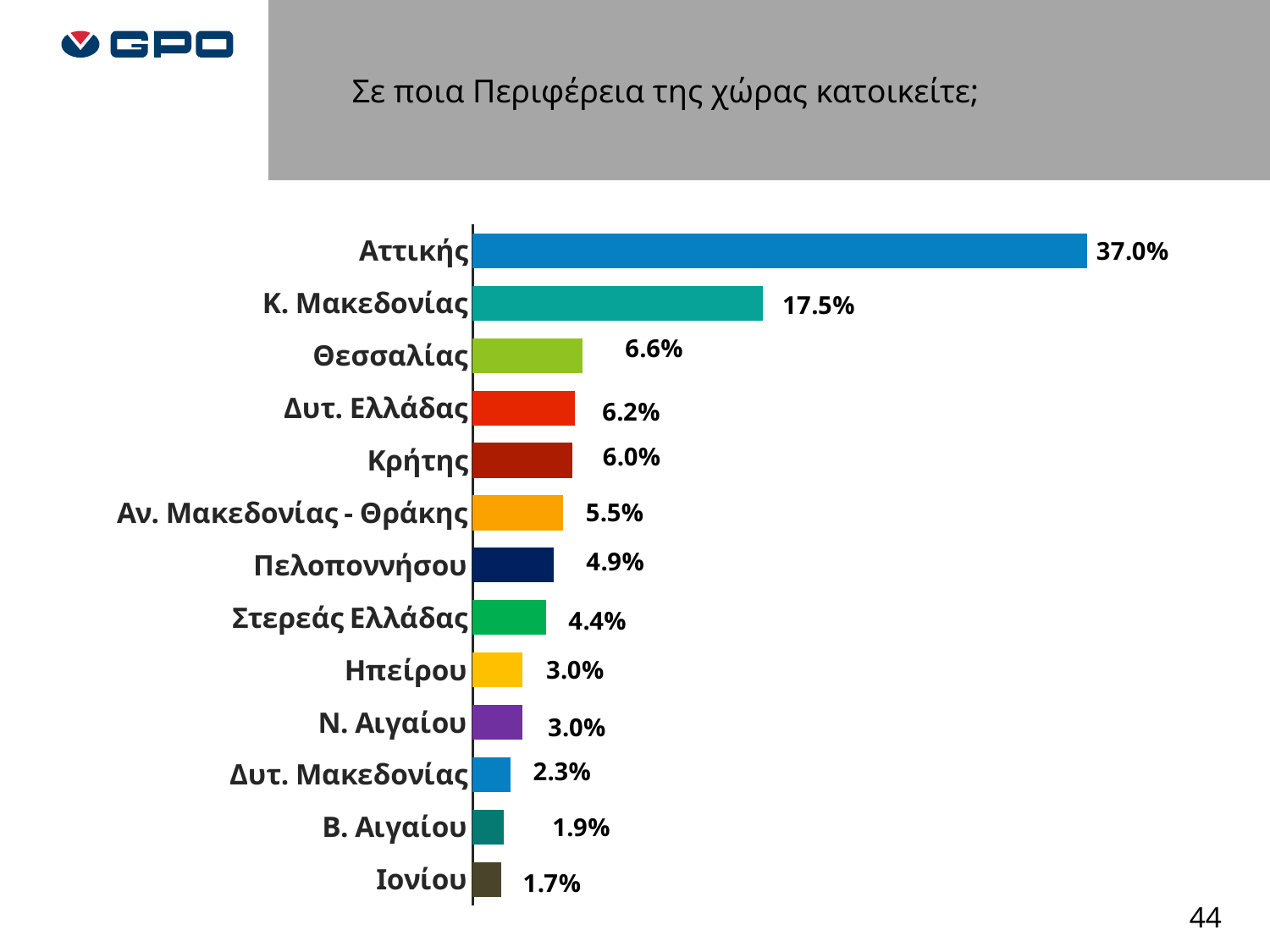
How many regions are shown in the chart? 13 Which region has the highest value? Αττικής What is the value for Κ. Μακεδονίας? 17.5% Which region has the lowest value? Ιονίου What is the difference between the values for Αττικής and Κ. Μακεδονίας? 19.5% What is the value for Ιονίου? 1.7% What kind of chart is shown on the slide? bar chart What is the value for Αττικής? 37.0% Which is larger, the value for Πελοποννήσου or the value for Στερεάς Ελλάδας? Πελοποννήσου What is the difference between the values for Θεσσαλίας and Δυτ. Ελλάδας? 0.4% What is the value for Κρήτης? 6.0% What is the title of the chart? Σε ποια Περιφέρεια της χώρας κατοικείτε;